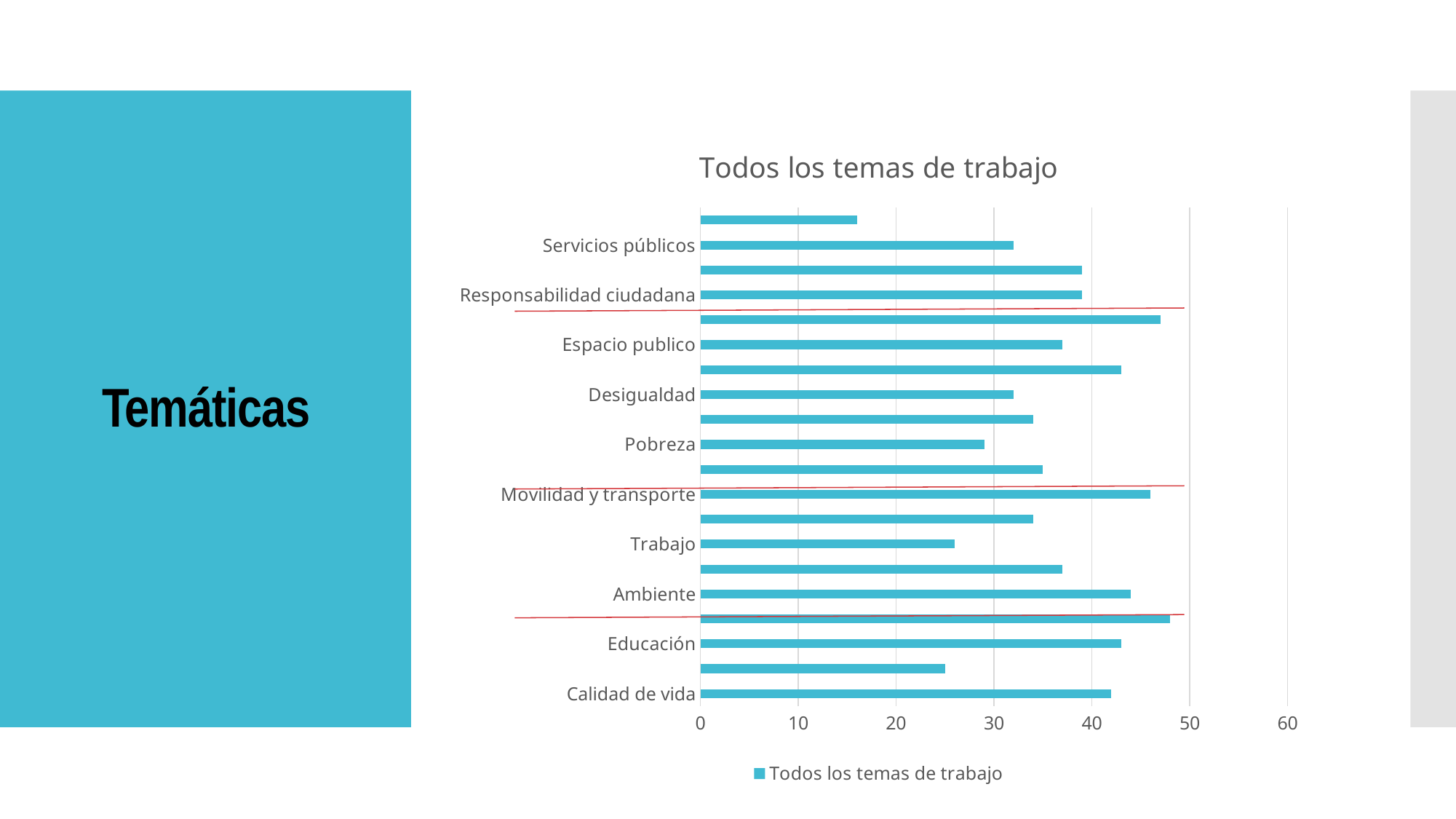
What kind of chart is shown on the slide? bar chart How many category labels are shown on the vertical axis of the chart? 10 What is the title of the chart? Todos los temas de trabajo Is the value for Espacio publico greater or less than 30? greater Which has the larger value, Ambiente or Pobreza? Ambiente Is the value for Pobreza greater or less than 30? less Is the value for Desigualdad greater or less than 40? less How many series does the legend list? 1 Which has the larger value, Movilidad y transporte or Trabajo? Movilidad y transporte